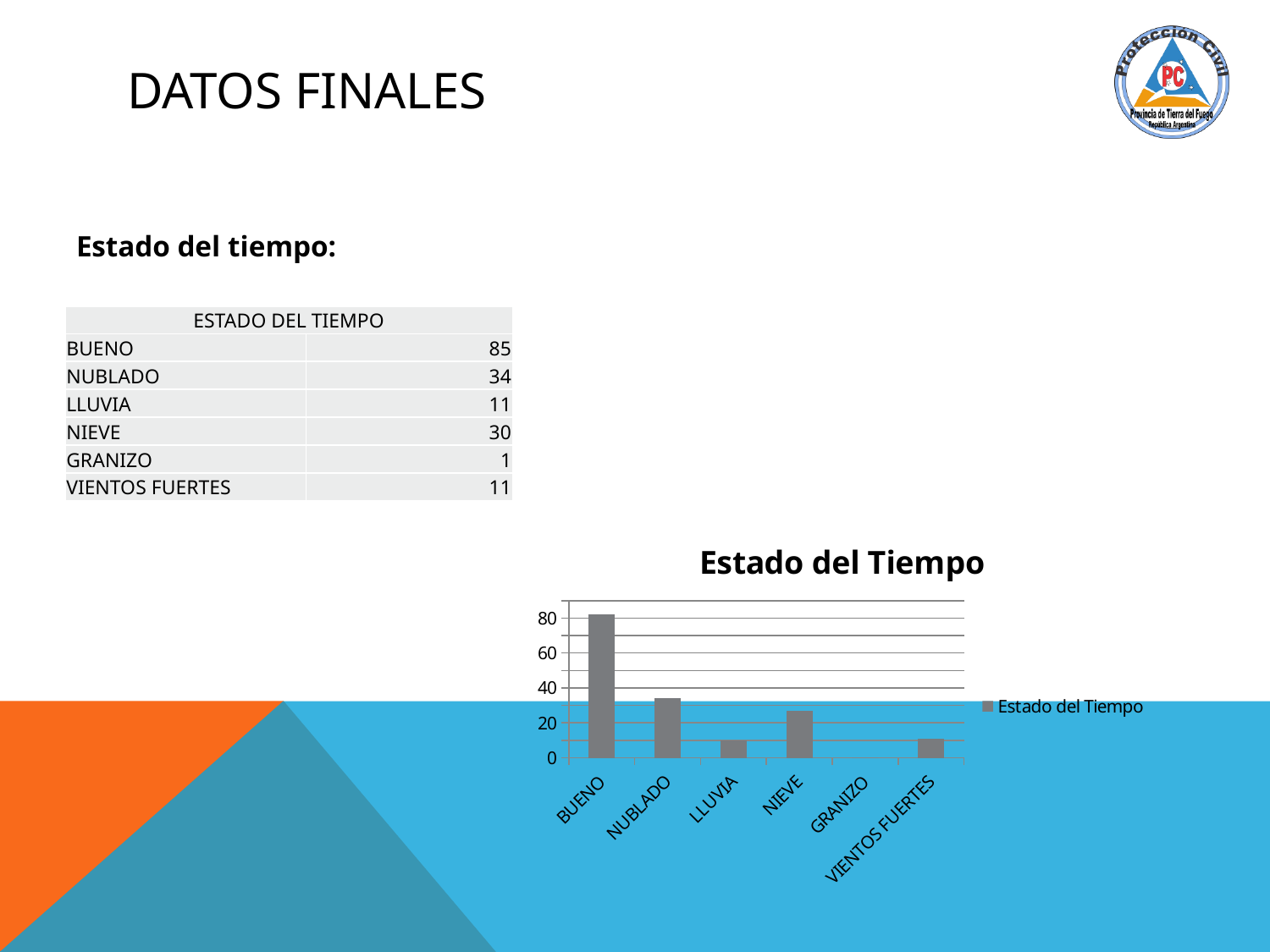
Which category has the highest bar in the chart? BUENO According to the table on the slide, what is the value for NUBLADO? 34 Is the value for NIEVE greater or less than 20? greater What kind of chart is shown on the slide? bar chart How many categories are shown on the x axis of the chart? 6 Using the values in the table, what is the difference between BUENO and NUBLADO? 51 Which category has the lowest bar in the chart? GRANIZO Is the value for LLUVIA greater or less than 20? less How many series does the chart legend list? 1 What is the title of the chart? Estado del Tiempo Which is larger, the value for BUENO or the value for NUBLADO? BUENO